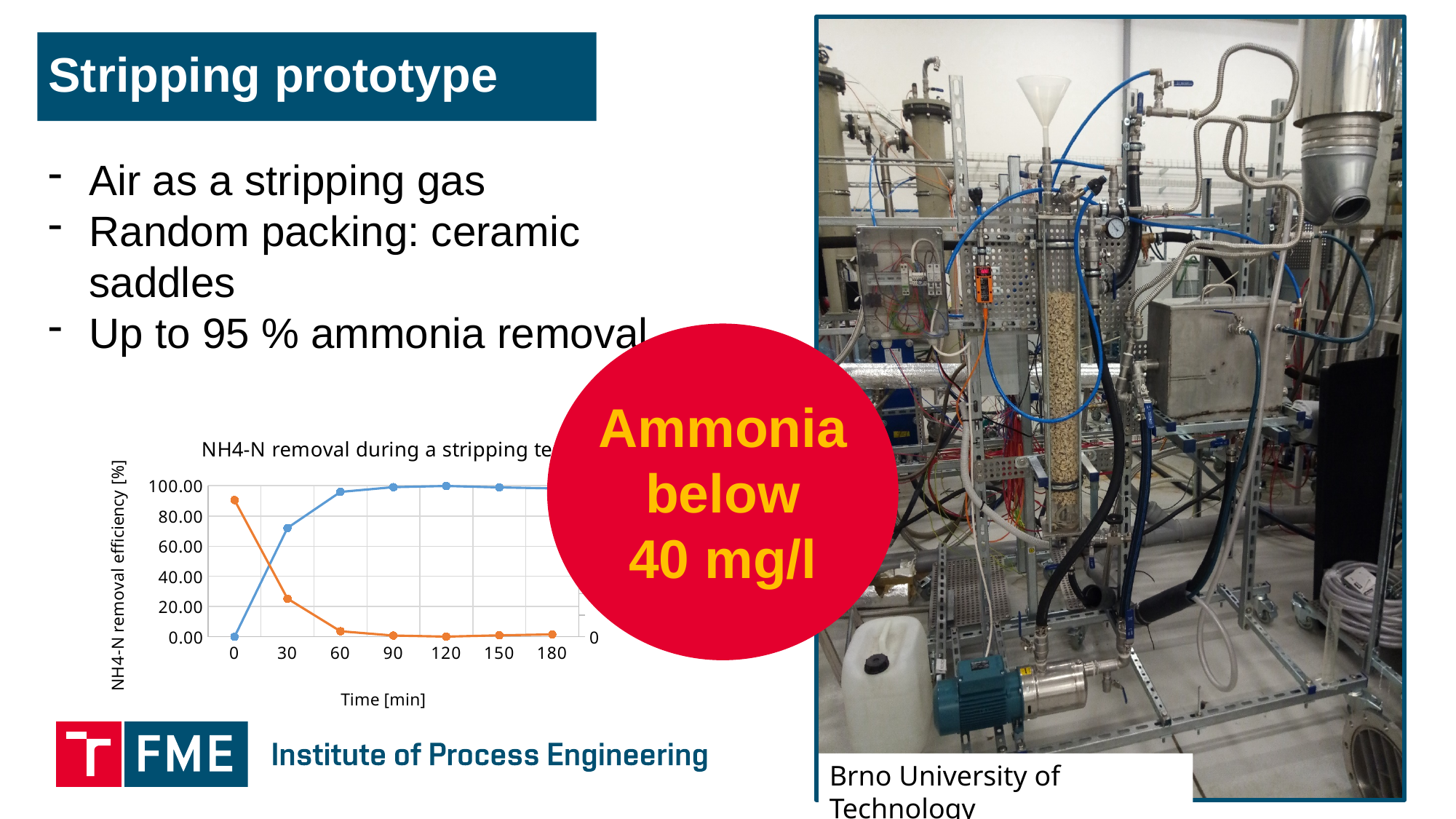
How many time points are marked on the x axis of the chart? 7 Does the blue line rise or fall as time increases along the x axis? rises Is the value of the blue line at 60 min greater or less than 80.00? greater Is the value of the orange line at 0 min greater or less than 80.00? greater What is the label of the x axis of the chart? Time [min] Is the value of the blue line at 30 min greater or less than 60.00? greater Does the orange line rise or fall as time increases along the x axis? falls At 0 min, which line has the higher value, the blue line or the orange line? the orange line What kind of chart is shown on the slide? line chart How many data series (lines) are plotted in the chart? 2